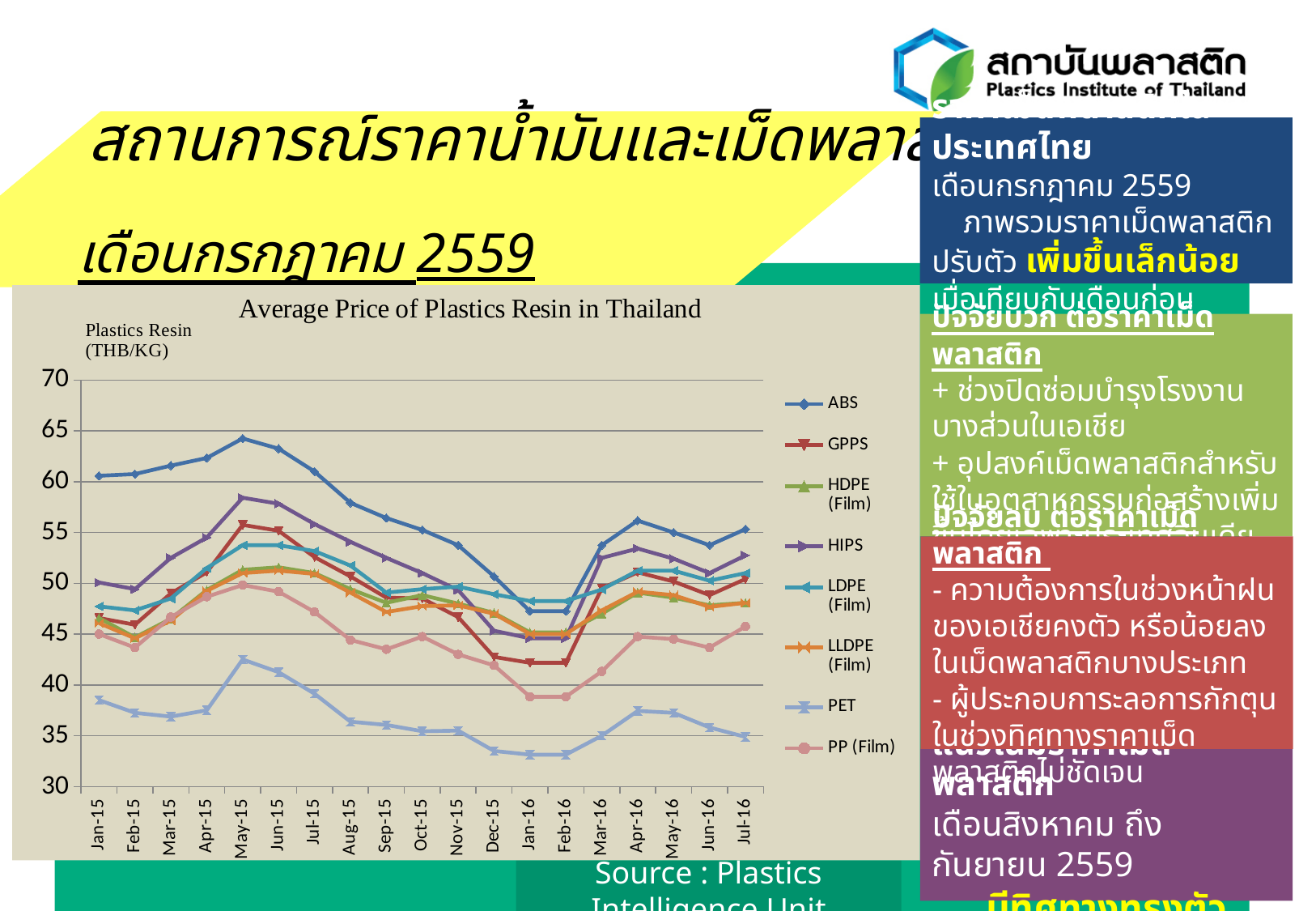
What is the title of the chart? Average Price of Plastics Resin in Thailand How many series does the chart legend list? 8 How many months are plotted along the x axis of the chart? 19 Is the value for PET in Jan-16 greater or less than 35? less In Jan-15, which is larger, the price of ABS or the price of PET? ABS Which series has the lowest price in Jan-16? PET Which series has the highest price in May-15? ABS What type of chart is shown on the slide? Line chart Is the value for ABS in May-15 greater or less than 60? greater Does the ABS price rise or fall from May-15 to Feb-16? Fall What unit is shown for the y axis of the chart? THB/KG Is the value for PP (Film) in Jan-16 greater or less than 40? less